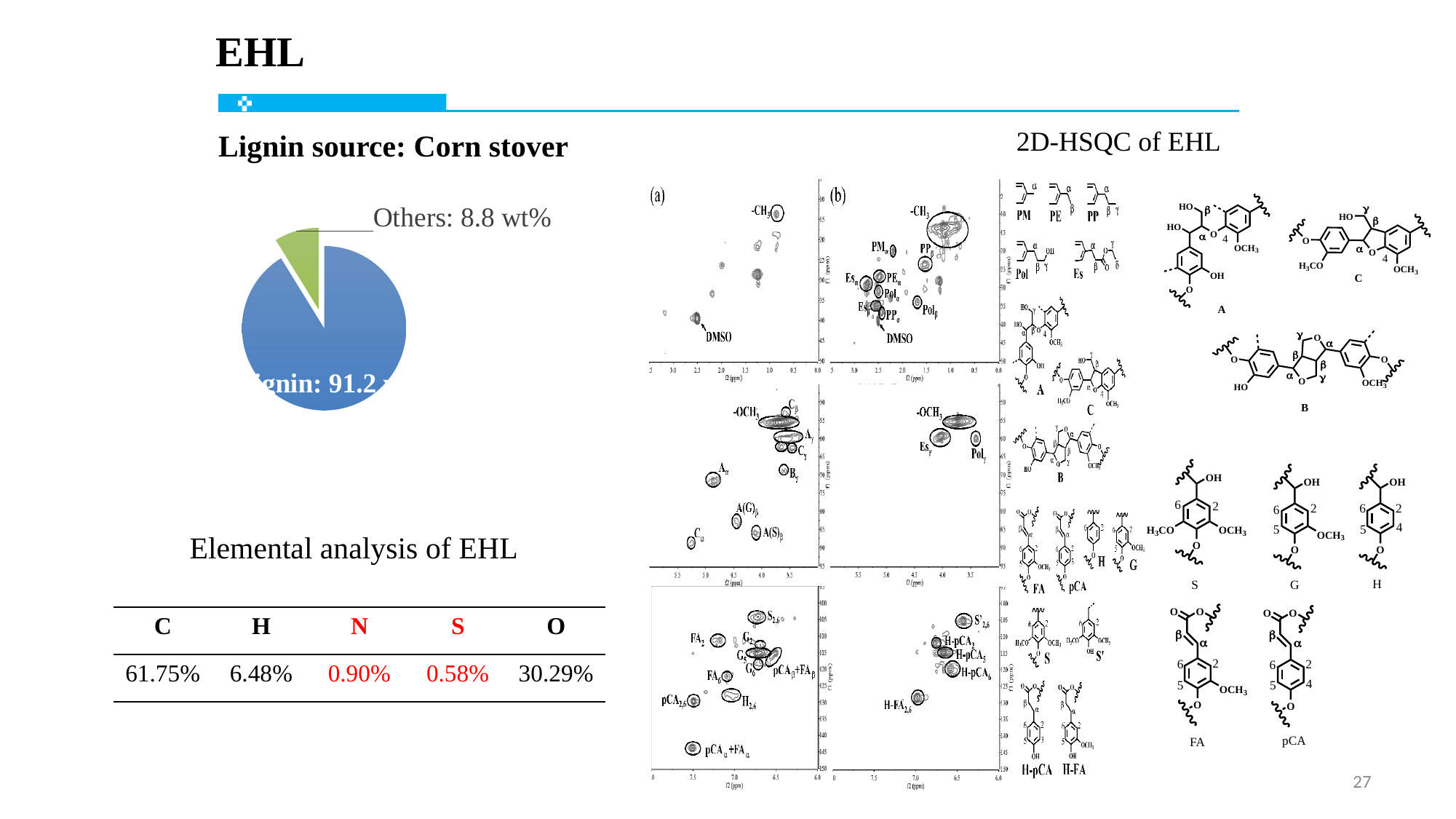
What is the value shown for Others in the pie chart? 8.8 wt% How many slices does the pie chart have? 2 Which slice of the pie chart is the largest? Lignin What do the two slices of the pie chart add up to? 100 wt% In the pie chart, which is larger, Lignin or Others? Lignin What colour is the Lignin slice in the pie chart? blue By how many wt% does the Lignin slice exceed the Others slice in the pie chart? 82.4 wt% Which slice of the pie chart is the smallest? Others What kind of chart is shown under 'Lignin source: Corn stover'? pie chart What is the value shown for Lignin in the pie chart? 91.2 wt% What colour is the Others slice in the pie chart? green